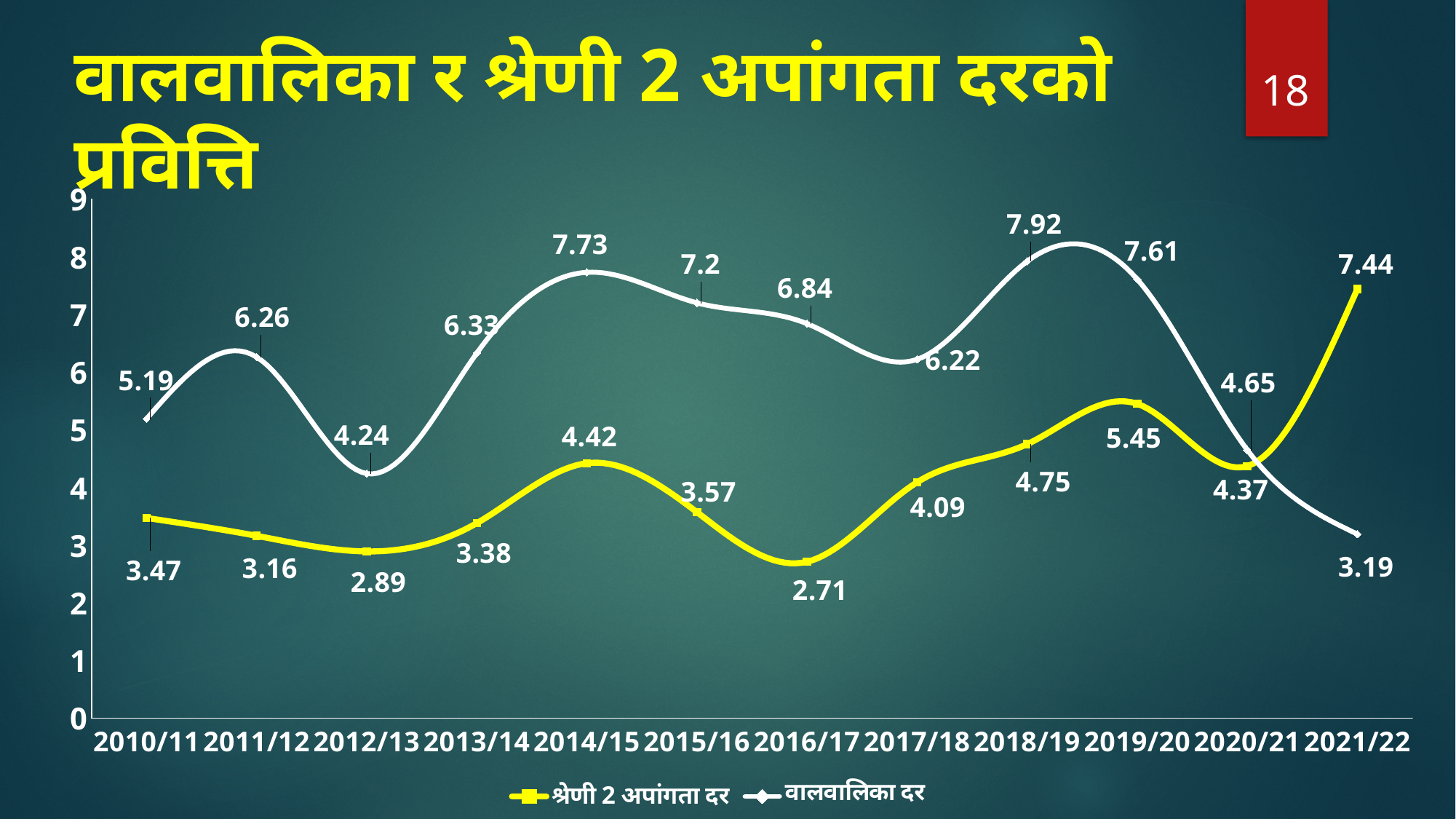
In which year does the वालवालिका दर series reach its highest value? 2018/19 How many years are shown on the x axis of the chart? 12 What is the value of the वालवालिका दर series for 2021/22? 3.19 Is the value of the वालवालिका दर series for 2012/13 greater or less than 5? less What is the value of the श्रेणी 2 अपांगता दर series for 2016/17? 2.71 What is the difference between the वालवालिका दर and श्रेणी 2 अपांगता दर values in 2010/11? 1.72 Which series has the larger value in 2021/22, श्रेणी 2 अपांगता दर or वालवालिका दर? श्रेणी 2 अपांगता दर Does the श्रेणी 2 अपांगता दर series rise or fall from 2020/21 to 2021/22? rise What kind of chart is shown on the slide? line chart What is the value of the वालवालिका दर series for 2014/15? 7.73 How many series does the chart's legend list? 2 In which year does the श्रेणी 2 अपांगता दर series have its lowest value? 2016/17